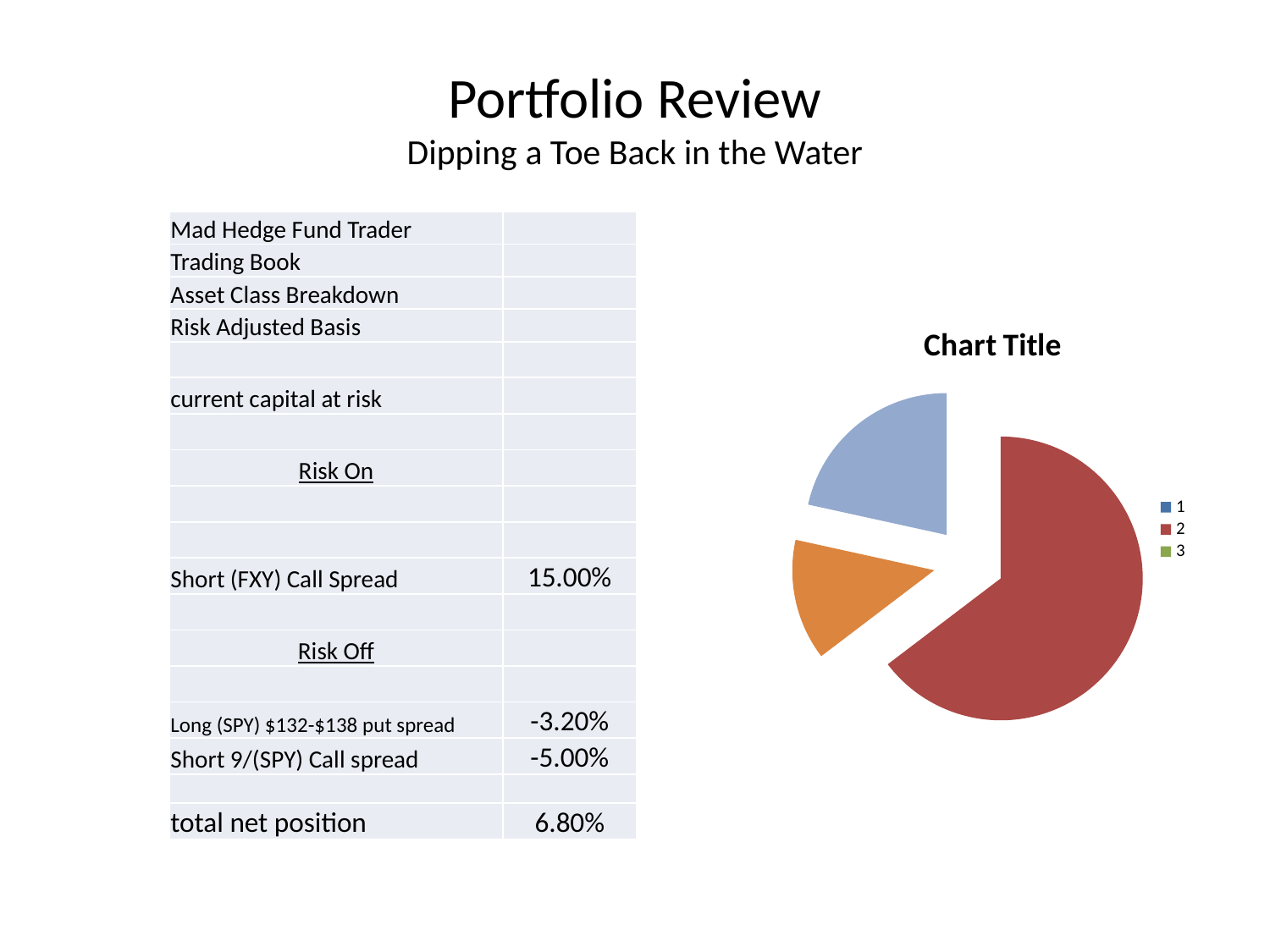
Which slice is larger in the pie chart, category 2 or category 1? 2 How many slices does the pie chart have? 3 What colour is the slice for category 2 in the pie chart? red How many entries does the chart's legend list? 3 Which category has the largest slice in the pie chart? 2 What kind of chart is shown on the slide? pie chart What is the title of the chart on the slide? Chart Title